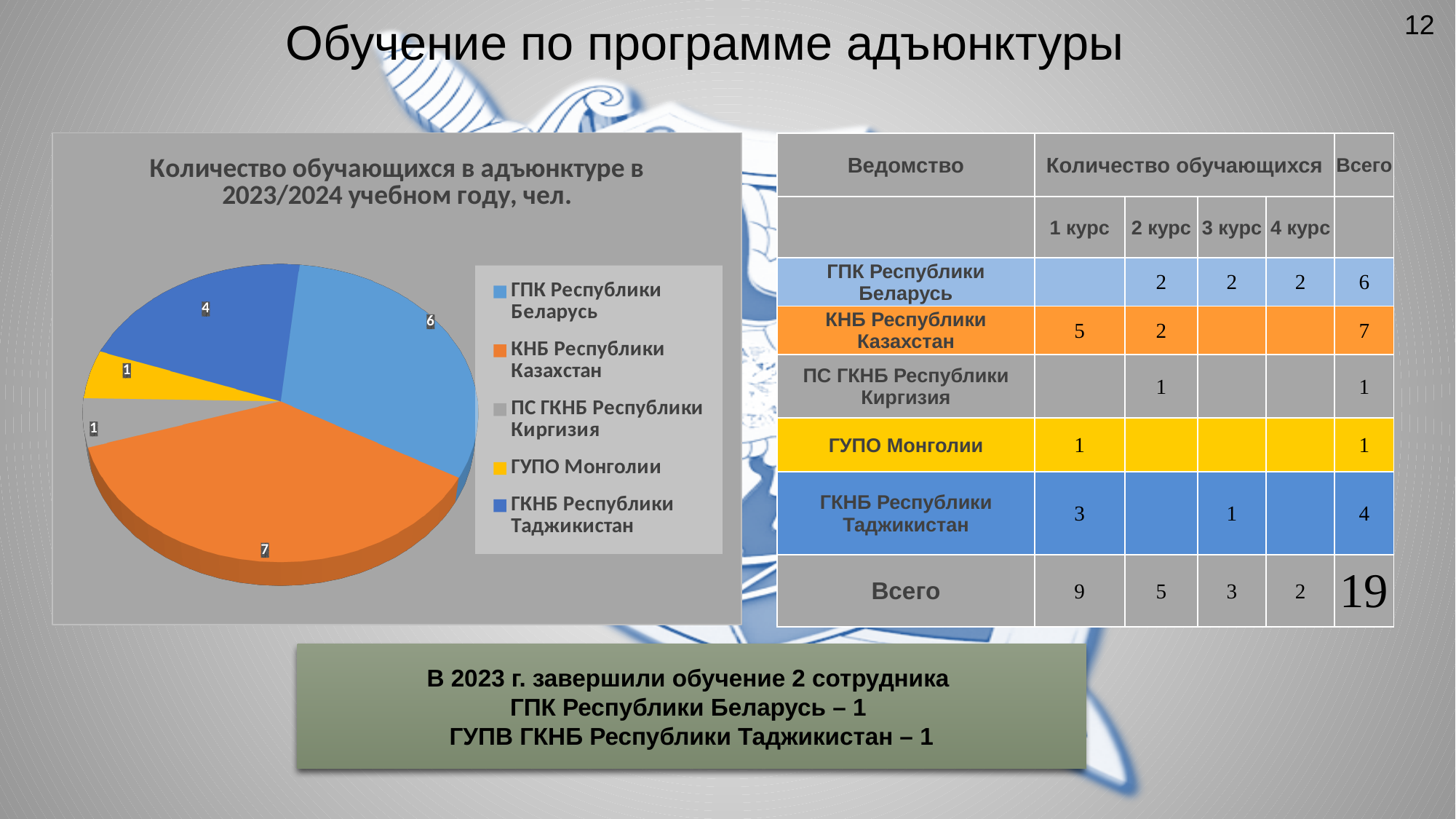
What is the value for ГПК Республики Беларусь in the pie chart? 6 Which is larger in the pie chart: ГПК Республики Беларусь or ГКНБ Республики Таджикистан? ГПК Республики Беларусь Which category has the largest slice in the pie chart? КНБ Республики Казахстан What type of chart is shown on the slide? pie chart What is the value for ГКНБ Республики Таджикистан in the pie chart? 4 What is the value for ГУПО Монголии in the pie chart? 1 What is the value for КНБ Республики Казахстан in the pie chart? 7 What colour is the slice for ГУПО Монголии in the pie chart? yellow What is the title of the pie chart? Количество обучающихся в адъюнктуре в 2023/2024 учебном году, чел. What is the total of all slices in the pie chart? 19 What is the difference between the values for КНБ Республики Казахстан and ГКНБ Республики Таджикистан? 3 How many categories does the pie chart legend list? 5